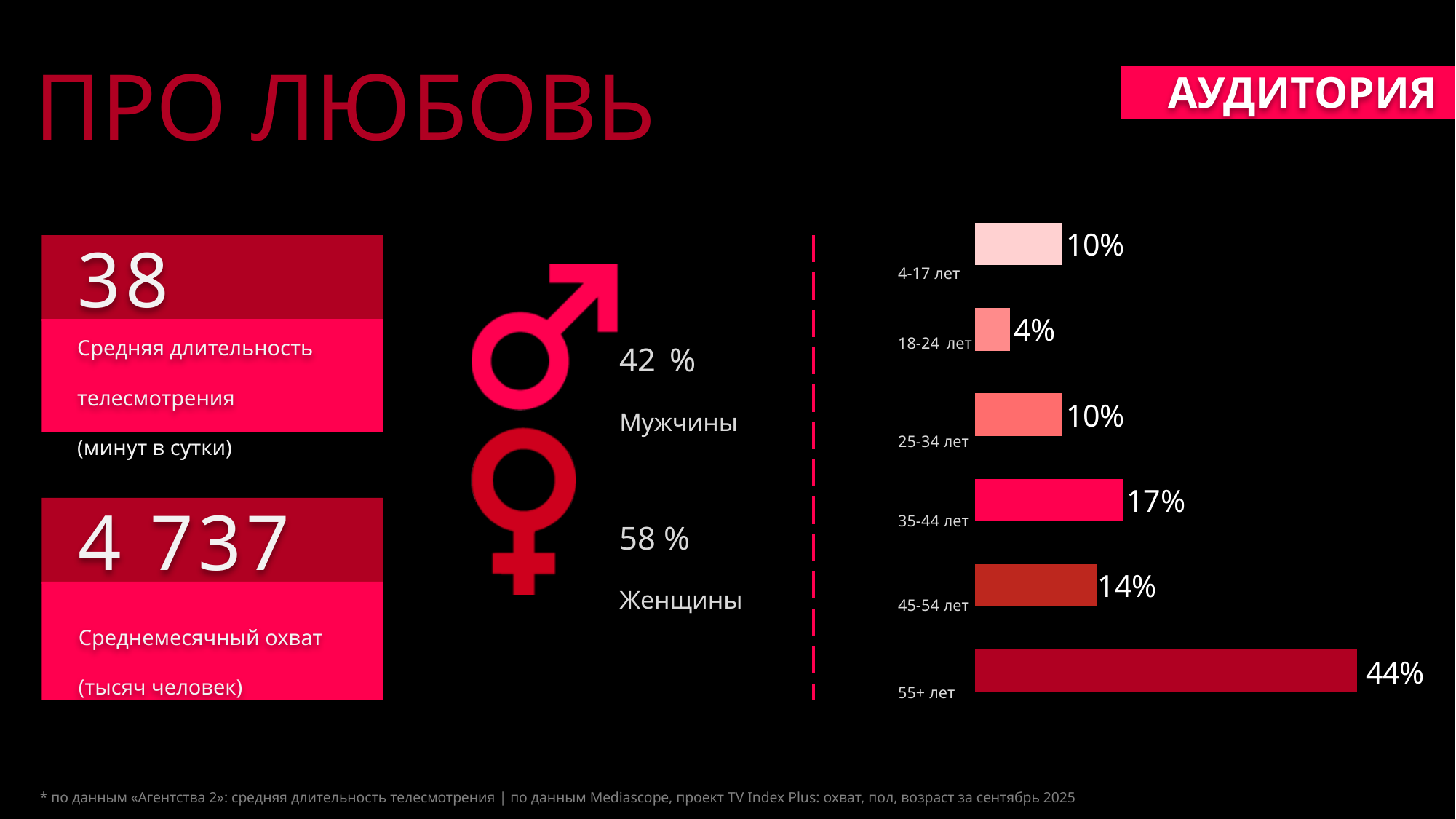
How many age groups are shown in the bar chart? 6 What kind of chart is used to show the age groups? bar chart Which is larger in the bar chart: the value for 35-44 лет or the value for 45-54 лет? 35-44 лет What is the value for the 55+ лет age group in the bar chart? 44% What is the value for the 18-24 лет age group in the bar chart? 4% What is the value for the 45-54 лет age group in the bar chart? 14% What is the difference between the values for 45-54 лет and 18-24 лет in the bar chart? 10% What is the difference between the values for 55+ лет and 35-44 лет in the bar chart? 27% What is the value for the 35-44 лет age group in the bar chart? 17% Which age group has the highest value in the bar chart? 55+ лет Which age group has the lowest value in the bar chart? 18-24 лет Which two age groups in the bar chart have the same value of 10%? 4-17 лет and 25-34 лет